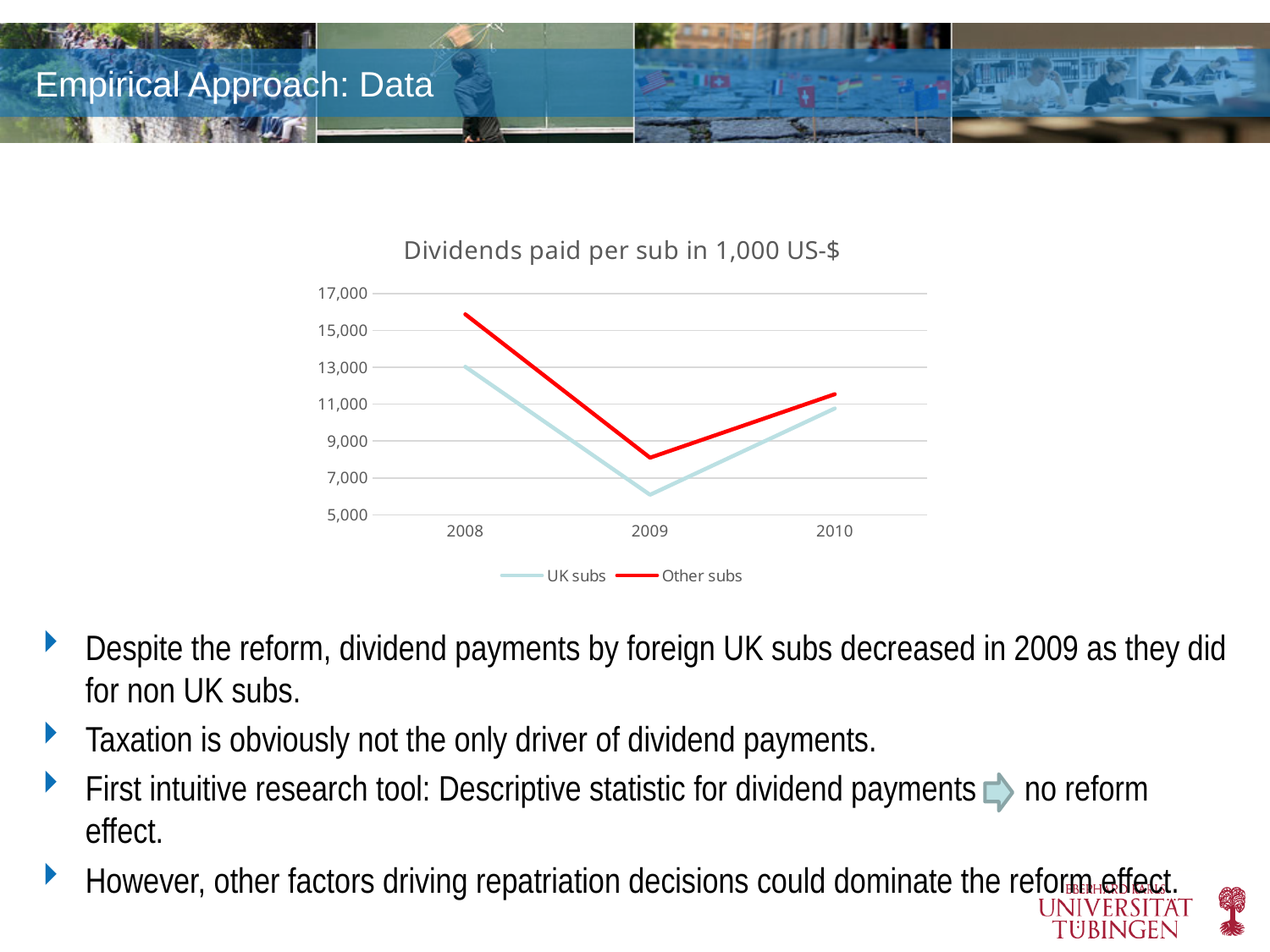
What kind of chart is shown on the slide? line chart Is the value for UK subs in 2009 greater or less than 7,000? less How many years are plotted along the x axis of the chart? 3 Is the value for Other subs in 2008 greater or less than 15,000? greater In 2009, which series has the higher value, UK subs or Other subs? Other subs Do the values for UK subs rise or fall from 2008 to 2009? fall What colour is the line for Other subs? red In which year is the value for Other subs lowest? 2009 How many series does the legend of the chart list? 2 Is the value for UK subs in 2010 greater or less than 9,000? greater What is the title of the chart? Dividends paid per sub in 1,000 US-$